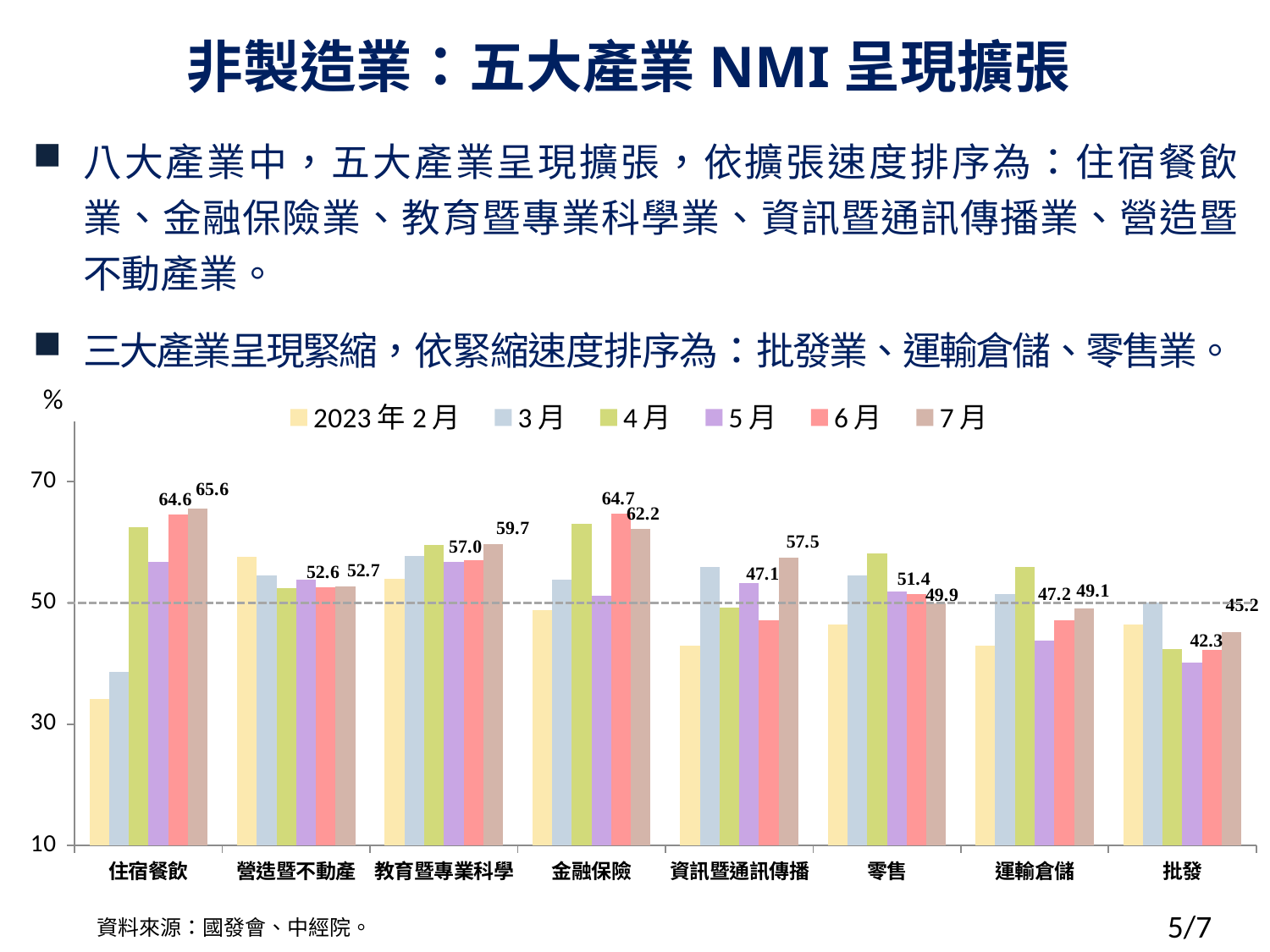
What is the 7月 value for 住宿餐飲? 65.6 What is the difference between the 6月 and 7月 values for 金融保險? 2.5 Which industry has the highest 7月 value? 住宿餐飲 Which is larger for 零售: the 6月 value or the 7月 value? 6月 What kind of chart is shown on the slide? bar chart What is the 7月 value for 資訊暨通訊傳播? 57.5 What is the 6月 value for 金融保險? 64.7 Is the 2023年2月 value for 住宿餐飲 greater or less than 50? less Which industry has the lowest 6月 value? 批發 How many series does the legend list? 6 What is the difference between the 7月 and 6月 values for 資訊暨通訊傳播? 10.4 How many industries are shown on the x axis? 8